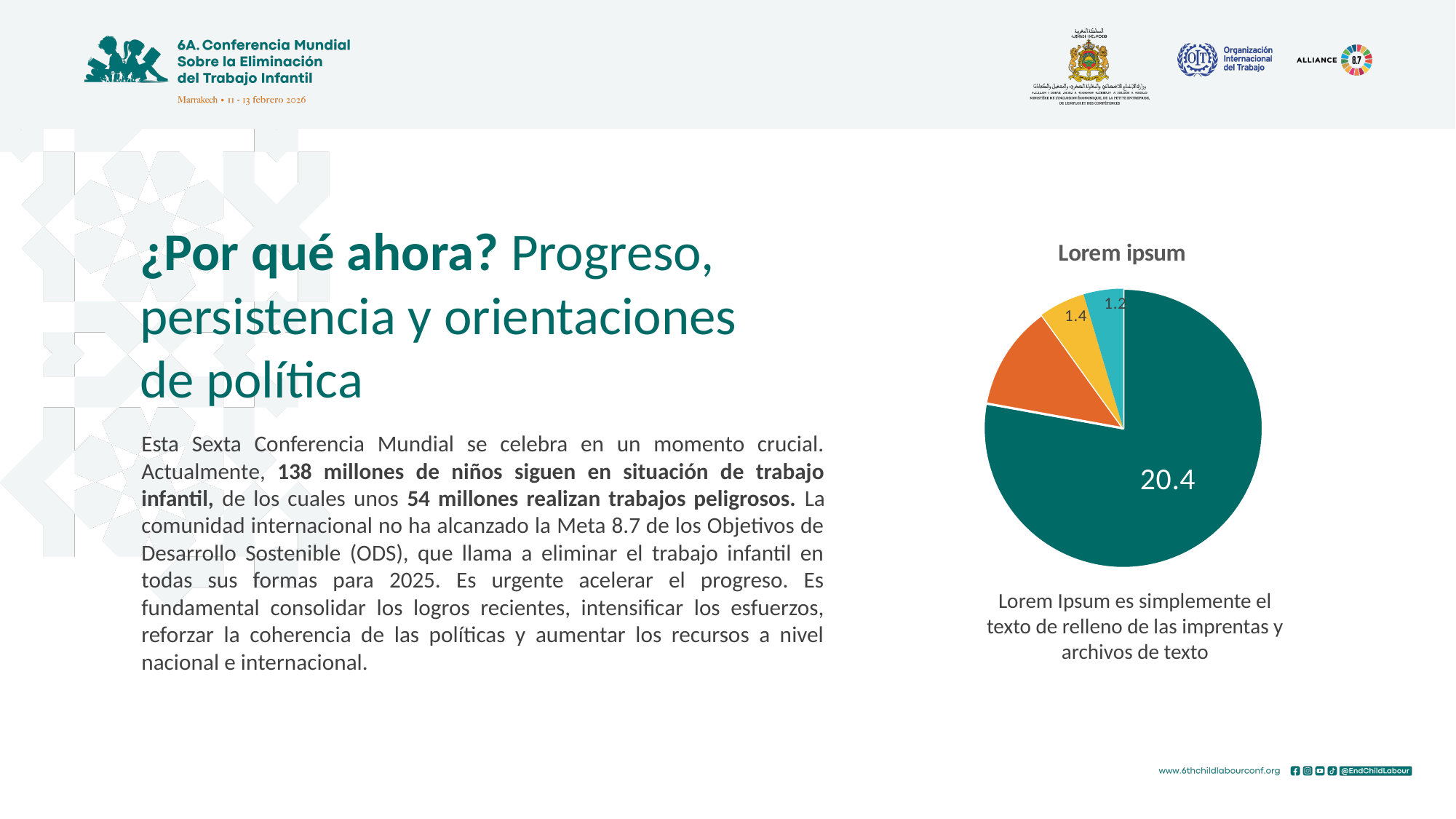
What value is labelled on the yellow slice of the pie chart? 1.4 Which slice of the pie chart is the smallest? the light teal slice (1.2) How many slices does the pie chart have? 4 What kind of chart is shown on the slide? pie chart What is the difference between the yellow slice (1.4) and the light teal slice (1.2)? 0.2 Which is larger in the pie chart, the orange slice or the yellow slice? the orange slice Which is larger in the pie chart, the yellow slice or the light teal slice? the yellow slice What value is labelled on the light teal slice of the pie chart? 1.2 What value is labelled on the large dark teal slice of the pie chart? 20.4 What is the title of the pie chart? Lorem ipsum Which slice of the pie chart is the largest? the dark teal slice (20.4) What is the difference between the dark teal slice (20.4) and the yellow slice (1.4)? 19